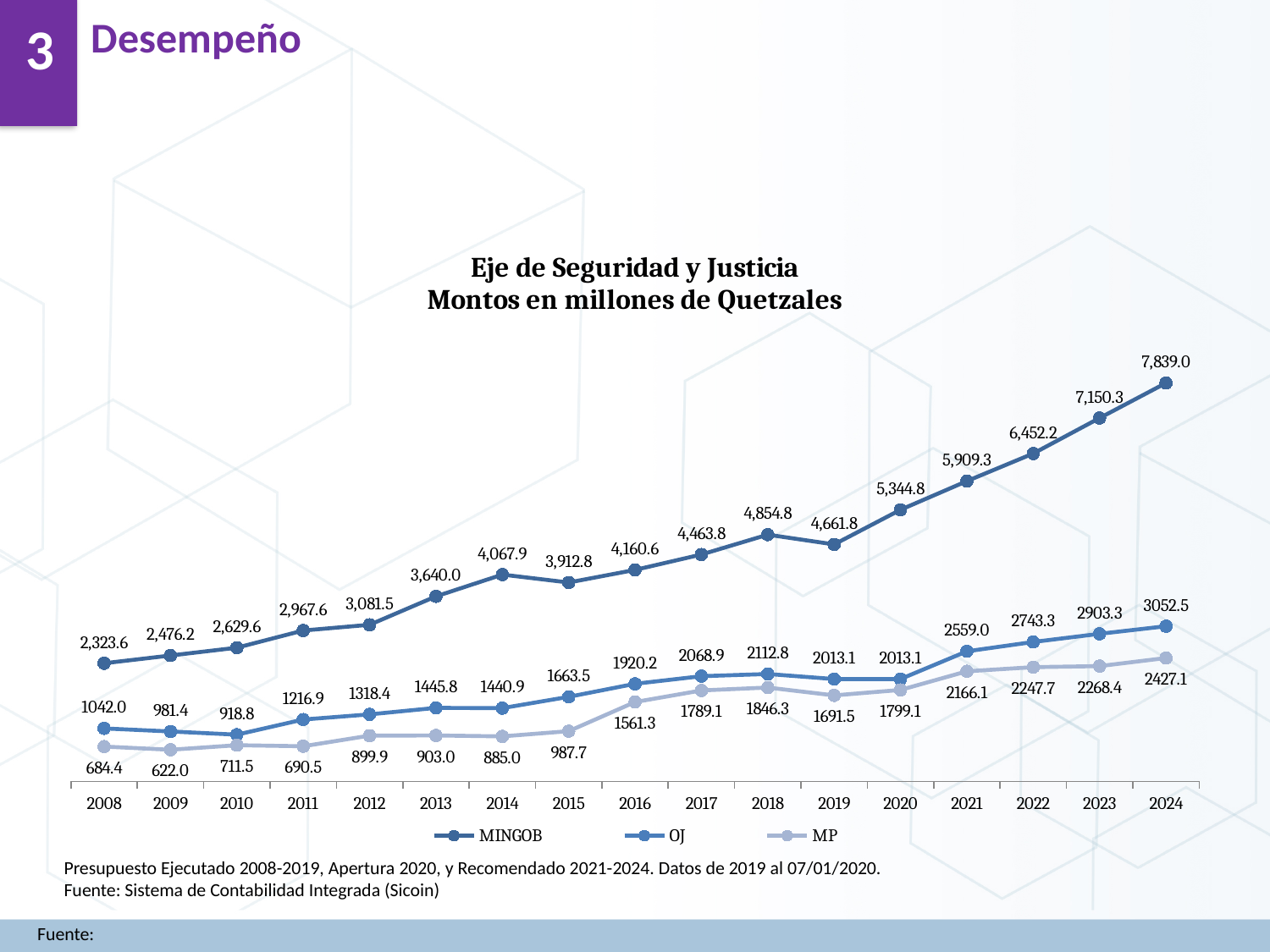
What is the MP value for 2009? 622.0 How many series does the legend list? 3 How many years are shown on the x axis? 17 In which year is the MINGOB value highest? 2024 What is the difference between the OJ and MP values in 2024? 625.4 Which series has the larger value in 2019, OJ or MP? OJ What is the difference between the MINGOB values for 2024 and 2023? 688.7 What is the MINGOB value for 2024? 7,839.0 What is the OJ value for 2016? 1920.2 What type of chart is shown on the slide? Line chart In which year is the MP value lowest? 2009 What is the title of the chart? Eje de Seguridad y Justicia Montos en millones de Quetzales